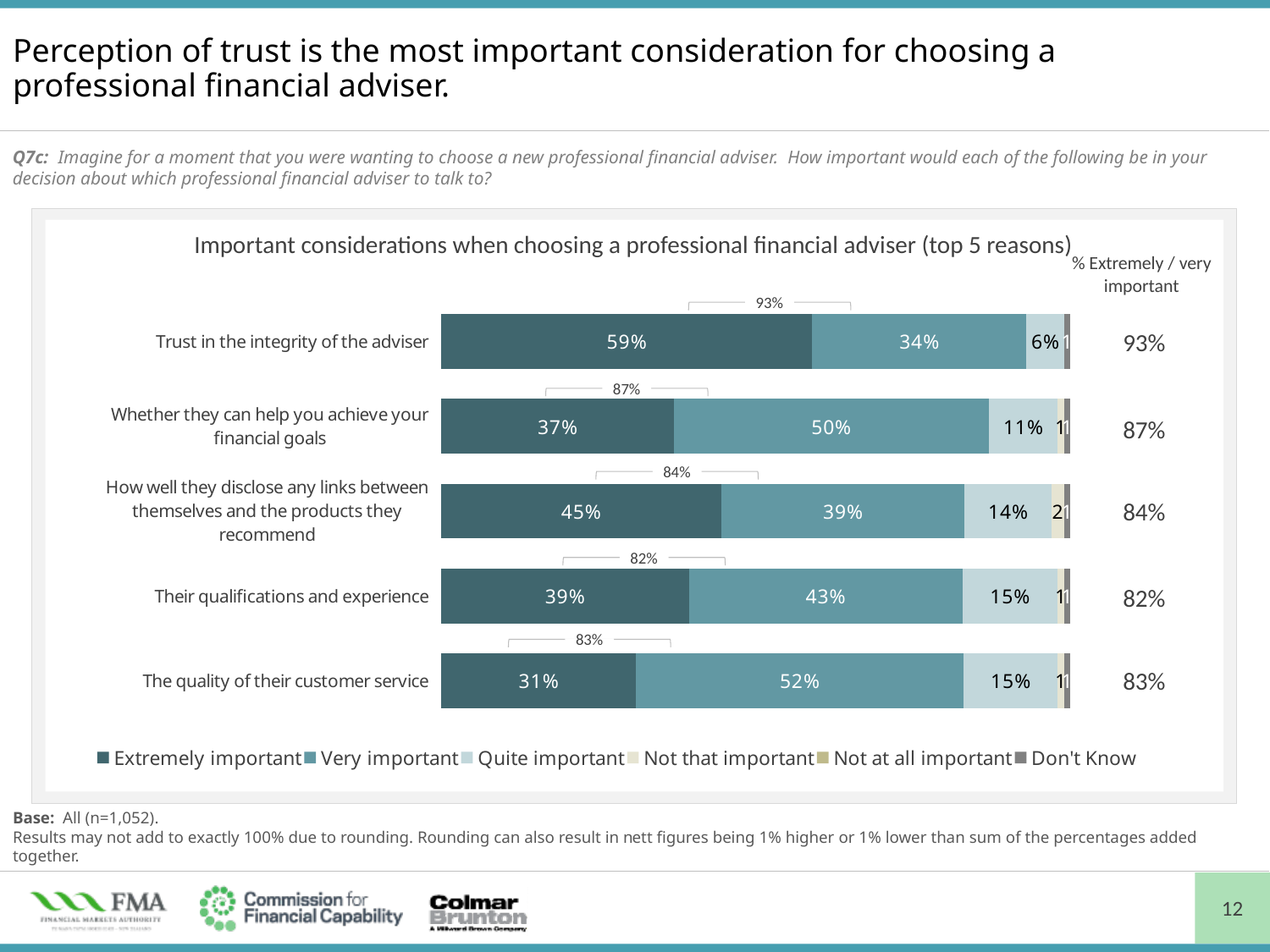
What kind of chart is shown on the slide? Stacked bar chart What is the difference between the Extremely important percentages for 'Trust in the integrity of the adviser' and 'The quality of their customer service'? 28% What is the title of the chart? Important considerations when choosing a professional financial adviser (top 5 reasons) Which consideration has the lowest Extremely important percentage? The quality of their customer service How many considerations (categories) are plotted in the chart? 5 What is the % Extremely / very important figure for 'How well they disclose any links between themselves and the products they recommend'? 84% What is the Quite important value for 'Their qualifications and experience'? 15% What percentage rated 'Whether they can help you achieve your financial goals' as Very important? 50% Which consideration has the highest % Extremely / very important figure? Trust in the integrity of the adviser What percentage rated 'Trust in the integrity of the adviser' as Extremely important? 59% Which is larger: the Very important value for 'The quality of their customer service' or for 'Their qualifications and experience'? The quality of their customer service How many series does the legend list? 6